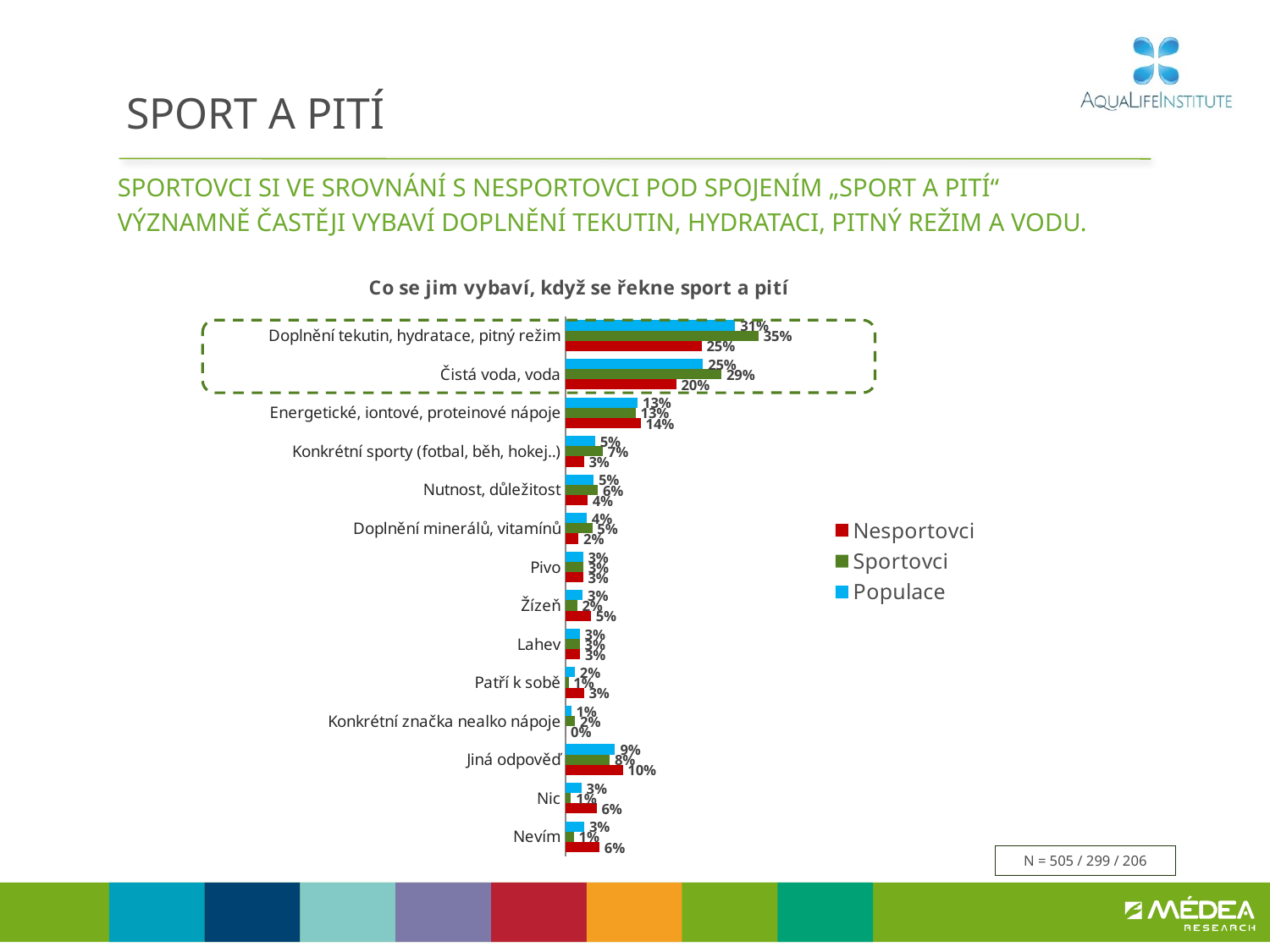
What is the value for Populace in the category "Energetické, iontové, proteinové nápoje"? 13% What is the title of the chart? Co se jim vybaví, když se řekne sport a pití How many categories are shown on the chart? 14 What is the value for Nesportovci in the category "Čistá voda, voda"? 20% Which category has the lowest value for Nesportovci? Konkrétní značka nealko nápoje Which category has the highest value for Sportovci? Doplnění tekutin, hydratace, pitný režim What is the difference between the Sportovci and Nesportovci values for "Doplnění tekutin, hydratace, pitný režim"? 10 percentage points What kind of chart is shown on the slide? Bar chart How many series does the legend list? 3 What is the value for Nesportovci in the category "Jiná odpověď"? 10% For the category "Nic", which is larger: the Nesportovci value or the Sportovci value? Nesportovci What is the value for Sportovci in the category "Doplnění tekutin, hydratace, pitný režim"? 35%